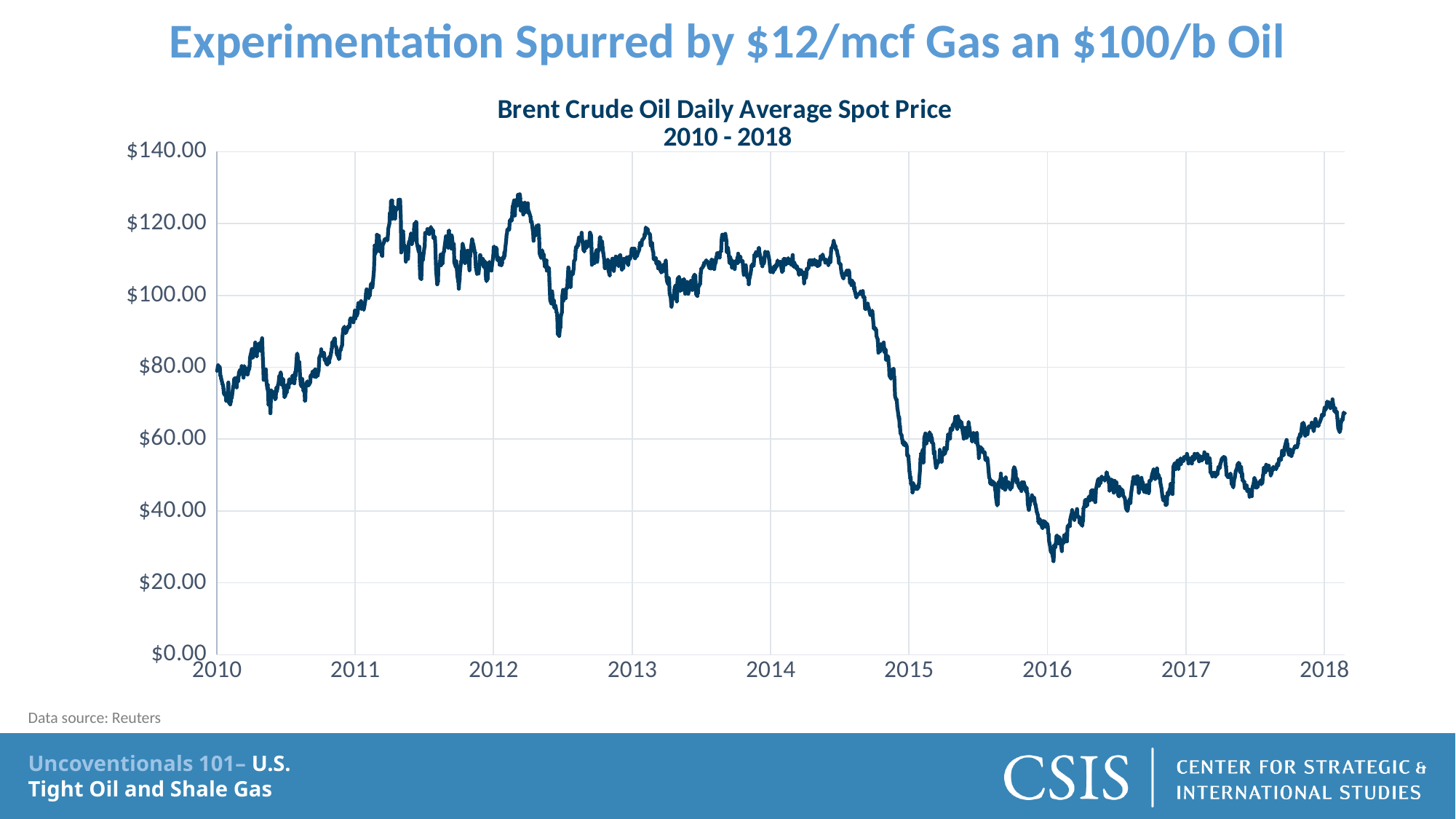
Is the Brent crude price at the start of 2012 greater or less than $100.00? greater Is the Brent crude price at the start of 2016 greater or less than $60.00? less Is the Brent crude price at the start of 2010 greater or less than $100.00? less Does the Brent crude price rise or fall between mid-2014 and the start of 2016? fall Does the Brent crude price rise or fall between the start of 2016 and the start of 2018? rise What data source is cited for the chart? Reuters In which year does the Brent crude price reach its lowest point on the chart? 2016 Which is larger, the Brent crude price at the start of 2012 or at the start of 2016? start of 2012 What is the title of the chart? Brent Crude Oil Daily Average Spot Price 2010 - 2018 What kind of chart is shown on the slide? line chart